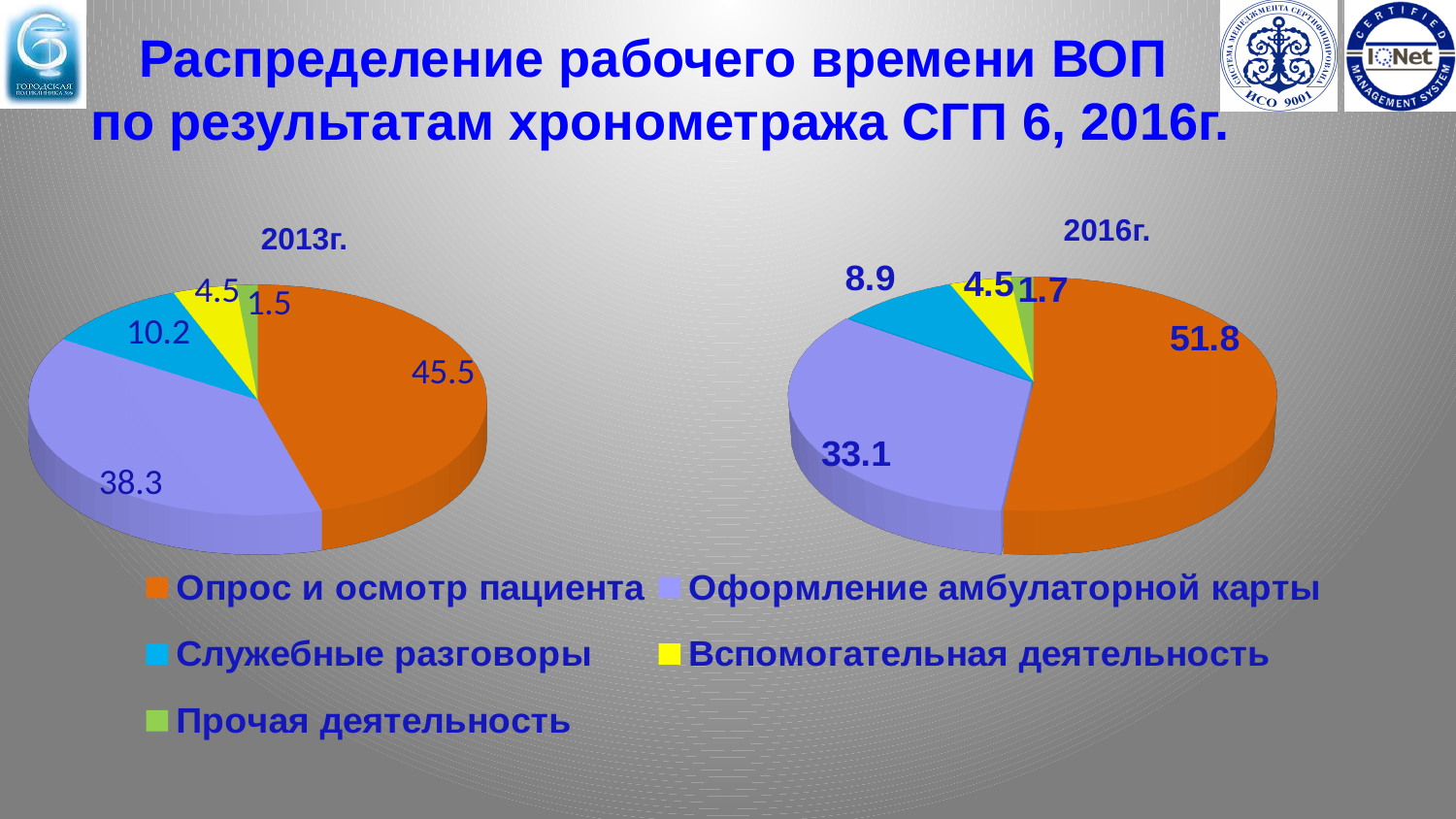
Which colour represents Вспомогательная деятельность in the legend? Yellow In the 2016г. pie chart, which category has the largest slice? Опрос и осмотр пациента How many slices does the 2016г. pie chart have? 5 Which is larger: Служебные разговоры in the 2013г. chart or in the 2016г. chart? 2013г. In the 2013г. pie chart, what is the difference between Оформление амбулаторной карты and Служебные разговоры? 28.1 In the 2013г. pie chart, what is the value for Прочая деятельность? 1.5 In the 2013г. pie chart, which category has the smallest slice? Прочая деятельность What type of chart is used on this slide? Pie chart In the 2016г. pie chart, what is the value for Оформление амбулаторной карты? 33.1 In the 2016г. pie chart, what is the value for Служебные разговоры? 8.9 In the 2013г. pie chart, what is the value for Опрос и осмотр пациента? 45.5 What is the difference between the value for Опрос и осмотр пациента in the 2016г. chart and in the 2013г. chart? 6.3